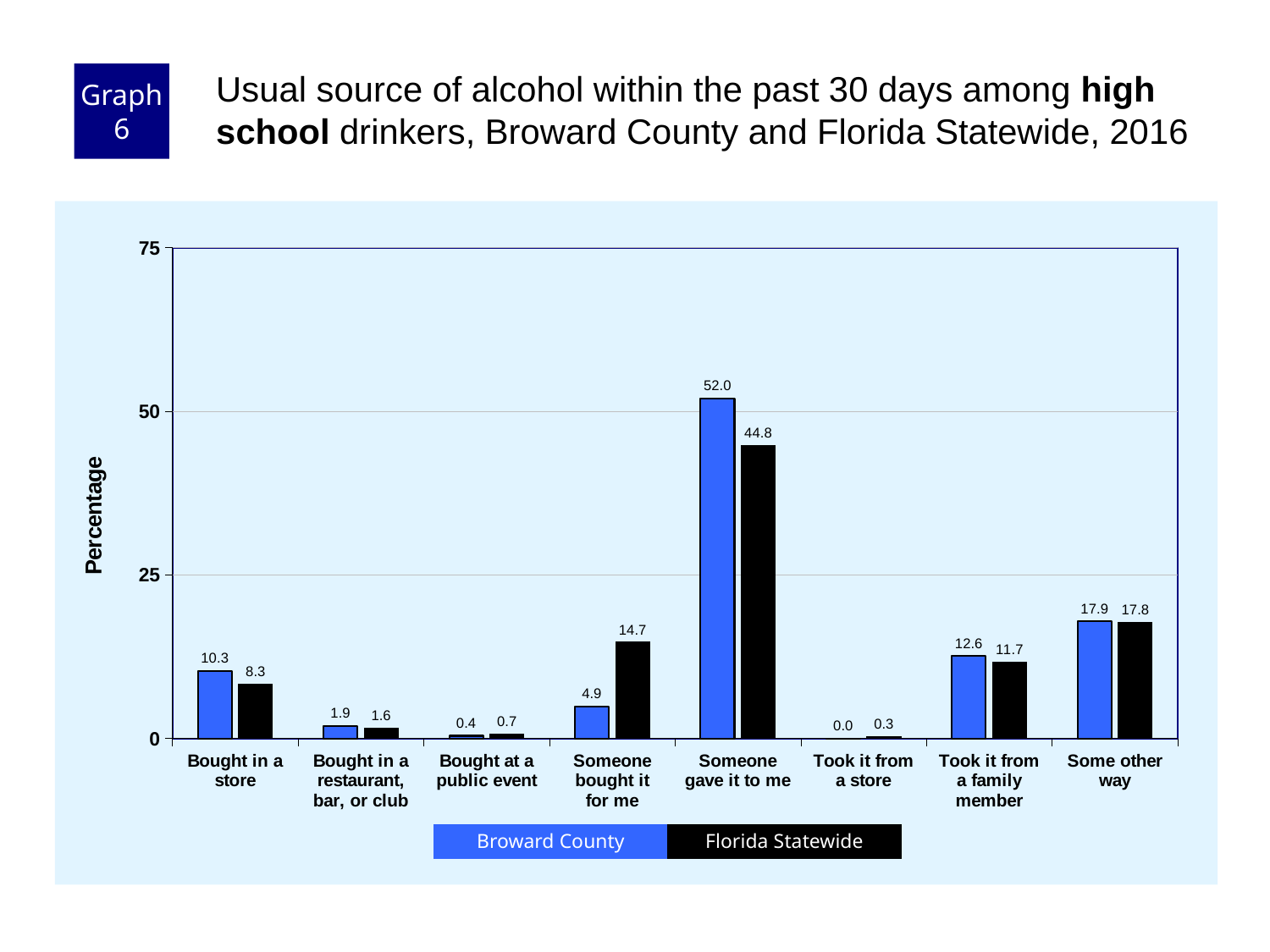
What is the Broward County value for "Took it from a store"? 0.0 Is the Florida Statewide value for "Someone gave it to me" greater or less than 50? less How many series does the legend list? 2 Which category has the lowest Broward County value? Took it from a store What is the Broward County value for "Someone gave it to me"? 52.0 What is the difference between the Broward County and Florida Statewide values for "Someone gave it to me"? 7.2 Which category has the highest Florida Statewide value? Someone gave it to me What is the Florida Statewide value for "Someone bought it for me"? 14.7 How many categories are shown on the x axis? 8 Which is larger for "Bought in a store": the Broward County value or the Florida Statewide value? Broward County What kind of chart is shown on the slide? bar chart What is the label of the y axis? Percentage